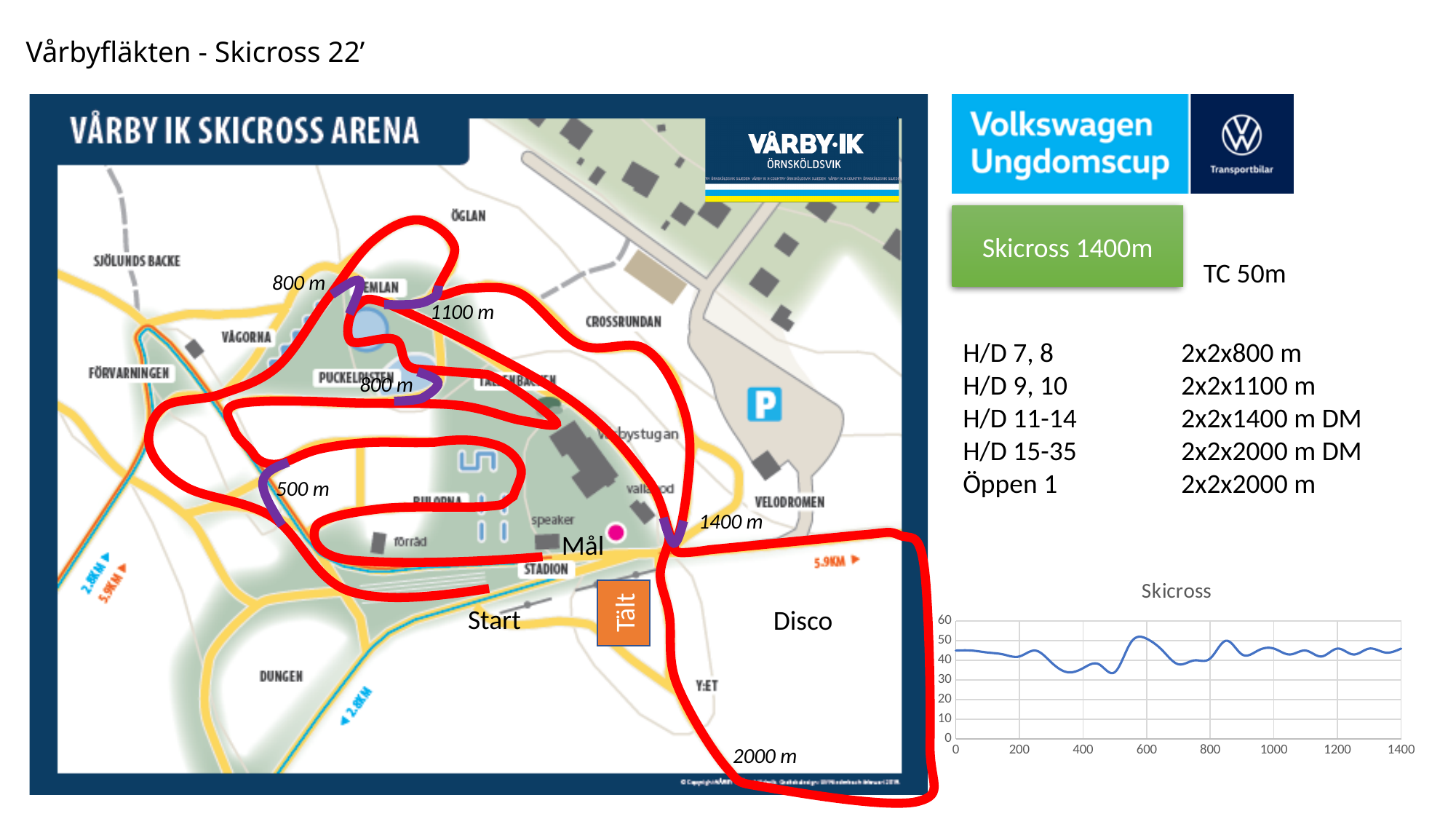
Does the Skicross line rise or fall between x = 200 and x = 400? fall Does the Skicross line rise or fall between x = 500 and x = 600? rise Is the value of the Skicross line at x = 400 greater or less than 30? greater What is the largest value shown on the x axis of the Skicross chart? 1400 What kind of chart is the "Skicross" chart? line chart Is the value of the Skicross line at x = 600 larger or smaller than the value at x = 400? larger Is the value of the Skicross line at x = 400 greater or less than 40? less How many tick labels are shown on the x axis of the Skicross chart? 8 Is the value of the Skicross line at x = 0 greater or less than 40? greater What is the title of the chart on the slide? Skicross